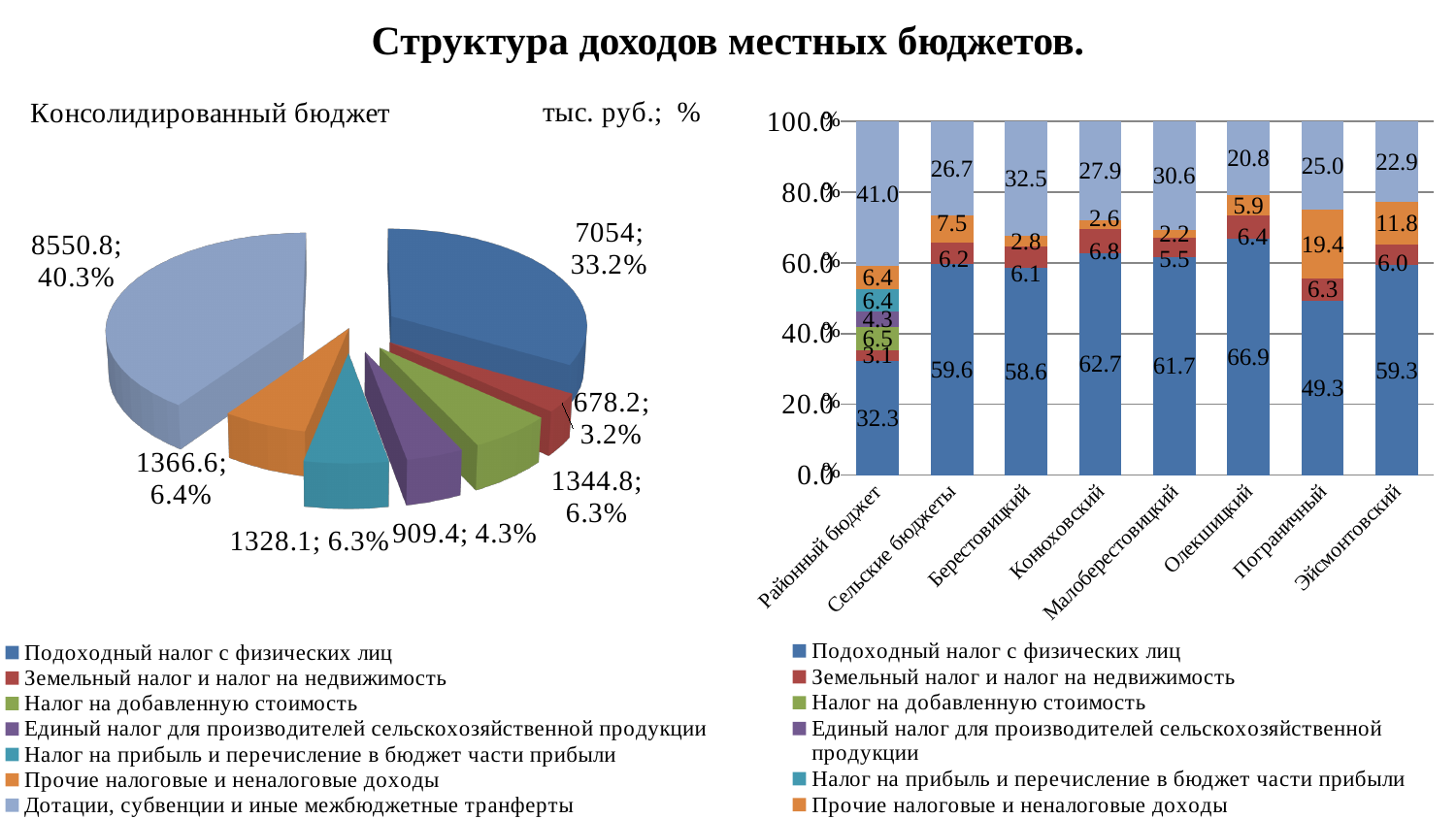
What kind of chart is the left chart (Консолидированный бюджет)? Pie chart In the pie chart (Консолидированный бюджет), what share is shown for Дотации, субвенции и иные межбюджетные трансферты? 40.3% In the pie chart (Консолидированный бюджет), which category has the smallest slice? Земельный налог и налог на недвижимость In the pie chart (Консолидированный бюджет), what value in тыс. руб. is shown for Подоходный налог с физических лиц? 7054 In the right bar chart, what is the difference between the Прочие налоговые и неналоговые доходы values for Пограничный (19.4) and Эйсмонтовский (11.8)? 7.6 What kind of chart is the right chart on the slide? Stacked bar chart How many slices does the pie chart (Консолидированный бюджет) have? 7 How many categories are shown on the x axis of the right bar chart? 8 In the right bar chart, which category has the lowest value for Подоходный налог с физических лиц? Районный бюджет How many series does the legend of the right bar chart list? 6 In the right bar chart, which category has the highest value for Подоходный налог с физических лиц? Олекшицкий In the right bar chart, what is the value of Подоходный налог с физических лиц for Олекшицкий? 66.9